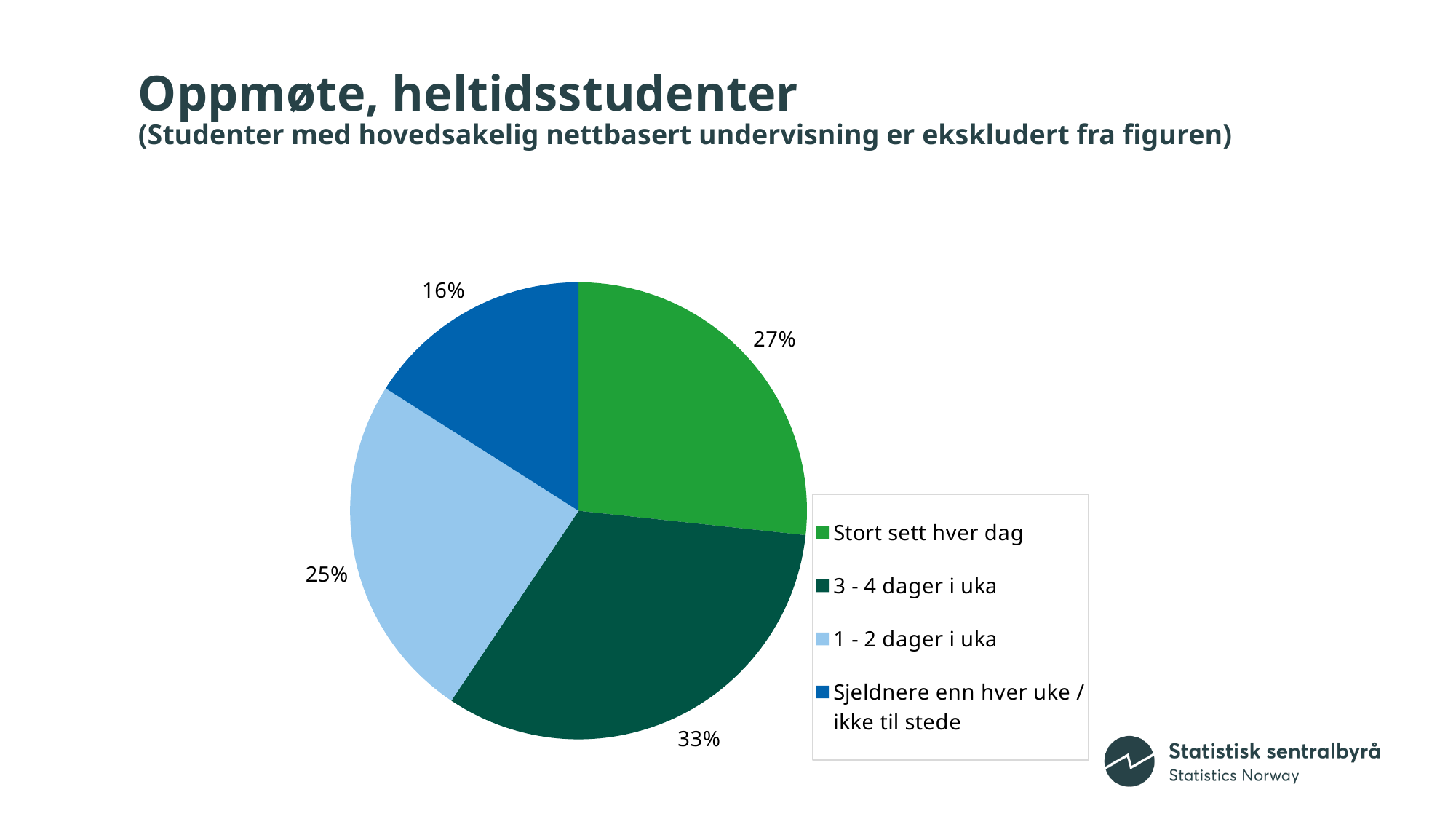
What is the difference in percentage points between '3 - 4 dager i uka' and 'Stort sett hver dag'? 6 percentage points Which category has the smallest slice of the pie? Sjeldnere enn hver uke / ikke til stede Which is larger: the share for 'Stort sett hver dag' or the share for '1 - 2 dager i uka'? Stort sett hver dag How many categories does the pie chart have? 4 Which category has the largest slice of the pie? 3 - 4 dager i uka What kind of chart is shown on the slide? pie chart What colour is the slice for '1 - 2 dager i uka'? light blue What share of full-time students attend '1 - 2 dager i uka'? 25% What is the title of the chart on the slide? Oppmøte, heltidsstudenter What share of full-time students attend 'Stort sett hver dag'? 27% What share of full-time students attend 'Sjeldnere enn hver uke / ikke til stede'? 16% What share of full-time students attend '3 - 4 dager i uka'? 33%